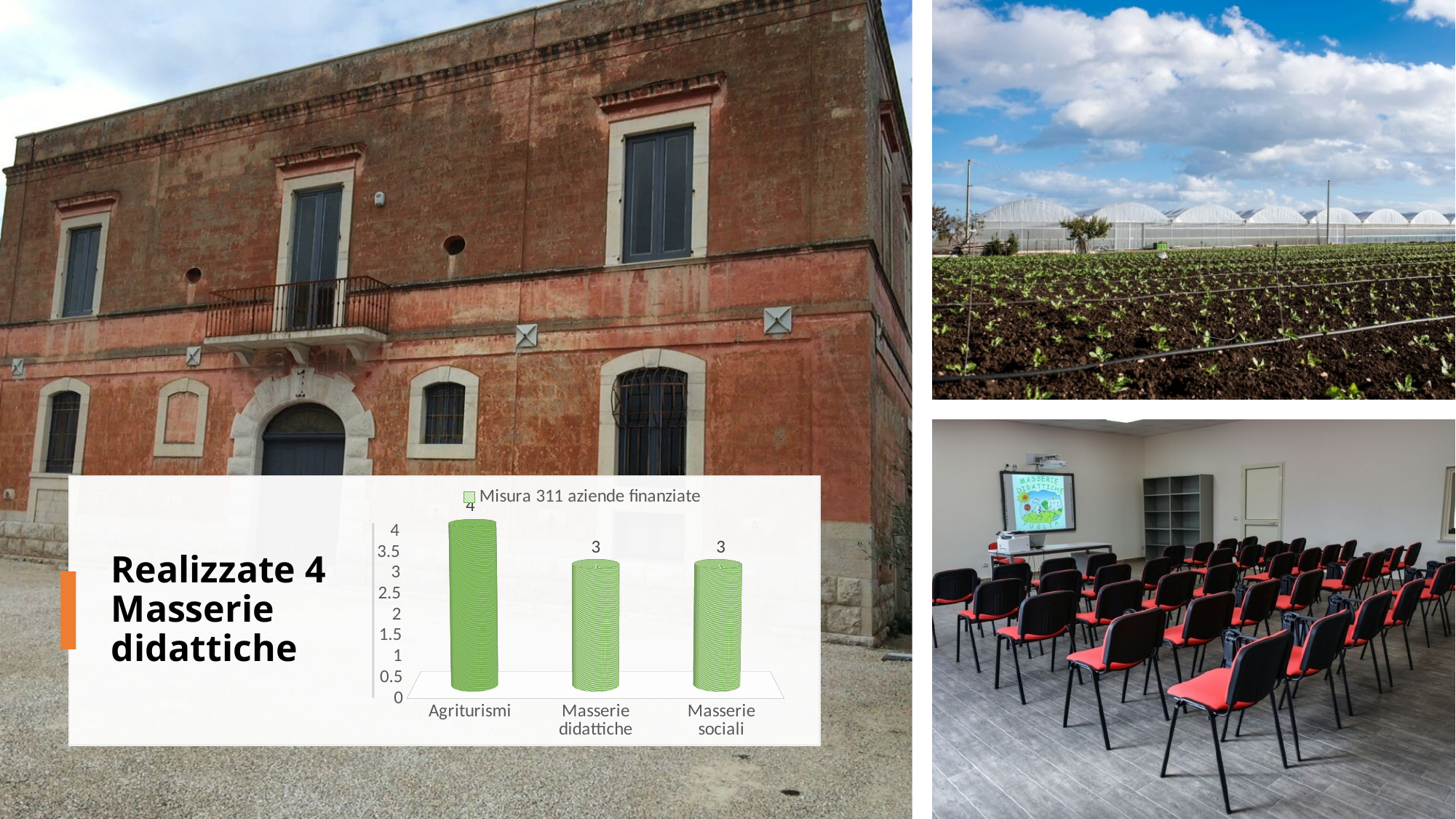
What kind of chart is shown? bar chart Which category has the highest value? Agriturismi What colour are the bars in the chart? green What is the difference between the values for Agriturismi and Masserie didattiche? 1 What is the value for Masserie didattiche? 3 What is the name of the series shown in the legend? Misura 311 aziende finanziate Is the value for Agriturismi greater or less than 3.5? greater How many series does the legend list? 1 What is the value for Agriturismi? 4 What is the value for Masserie sociali? 3 Which is larger, the value for Agriturismi or the value for Masserie sociali? Agriturismi How many categories are shown on the x axis? 3